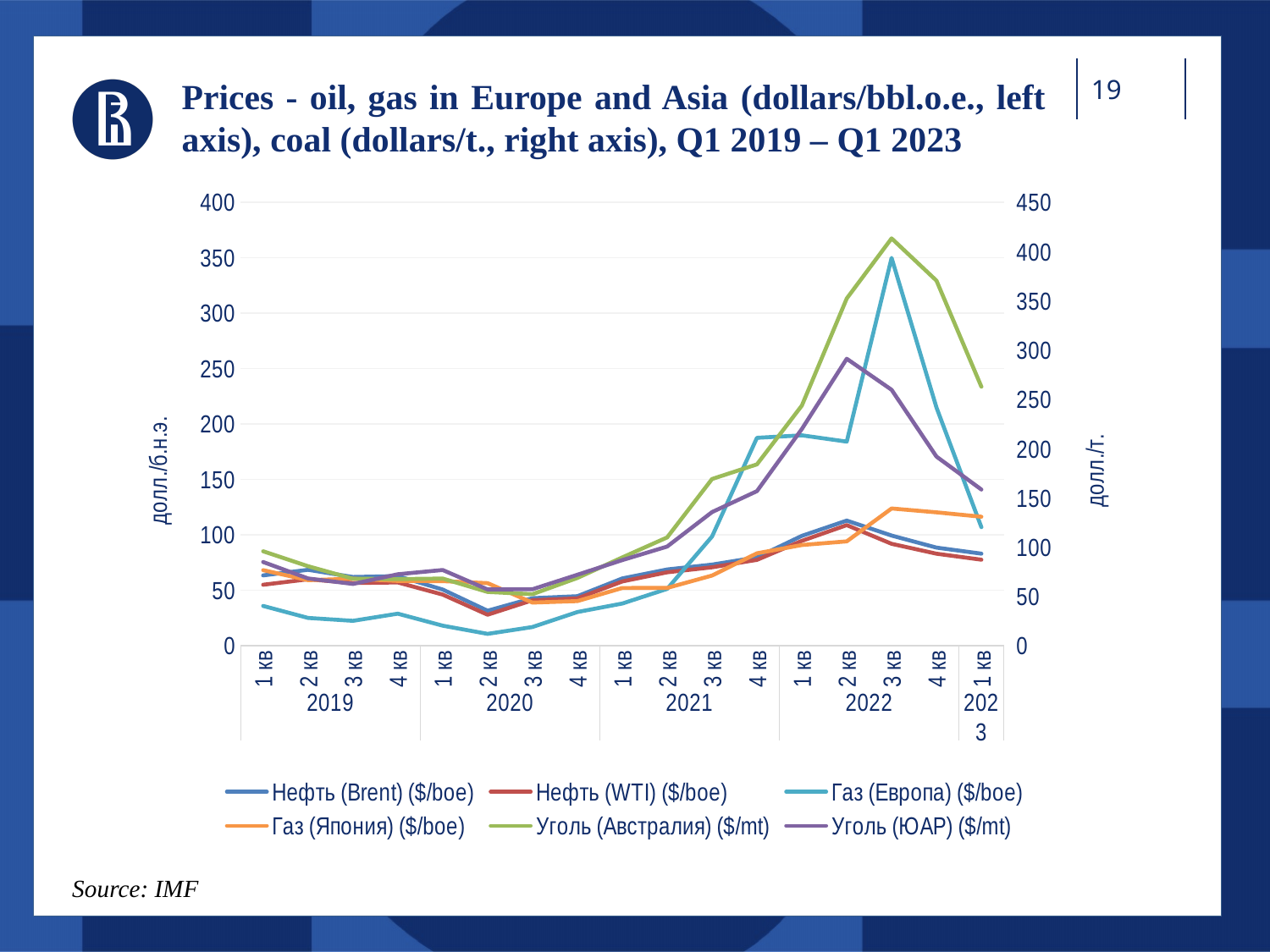
What kind of chart is shown on the slide? line chart In which quarter does the Газ (Европа) series reach its highest value? 3 кв 2022 How many series does the legend list? 6 In which quarter does the Уголь (Австралия) series reach its highest value? 3 кв 2022 Is the value for Уголь (Австралия) in 3 кв 2022 greater or less than 350 on the right axis? greater What source is cited for the chart? IMF Does the Газ (Европа) series rise or fall from 3 кв 2022 to 1 кв 2023? fall How many quarterly points are plotted along the x axis? 17 Is the value for Газ (Европа) in 3 кв 2022 greater or less than 300 on the left axis? greater In which quarter is the Газ (Европа) series at its lowest? 2 кв 2020 In 3 кв 2022, which is higher: Нефть (Brent) or Нефть (WTI)? Нефть (Brent) Is the value for Нефть (Brent) in 2 кв 2020 greater or less than 50 on the left axis? less